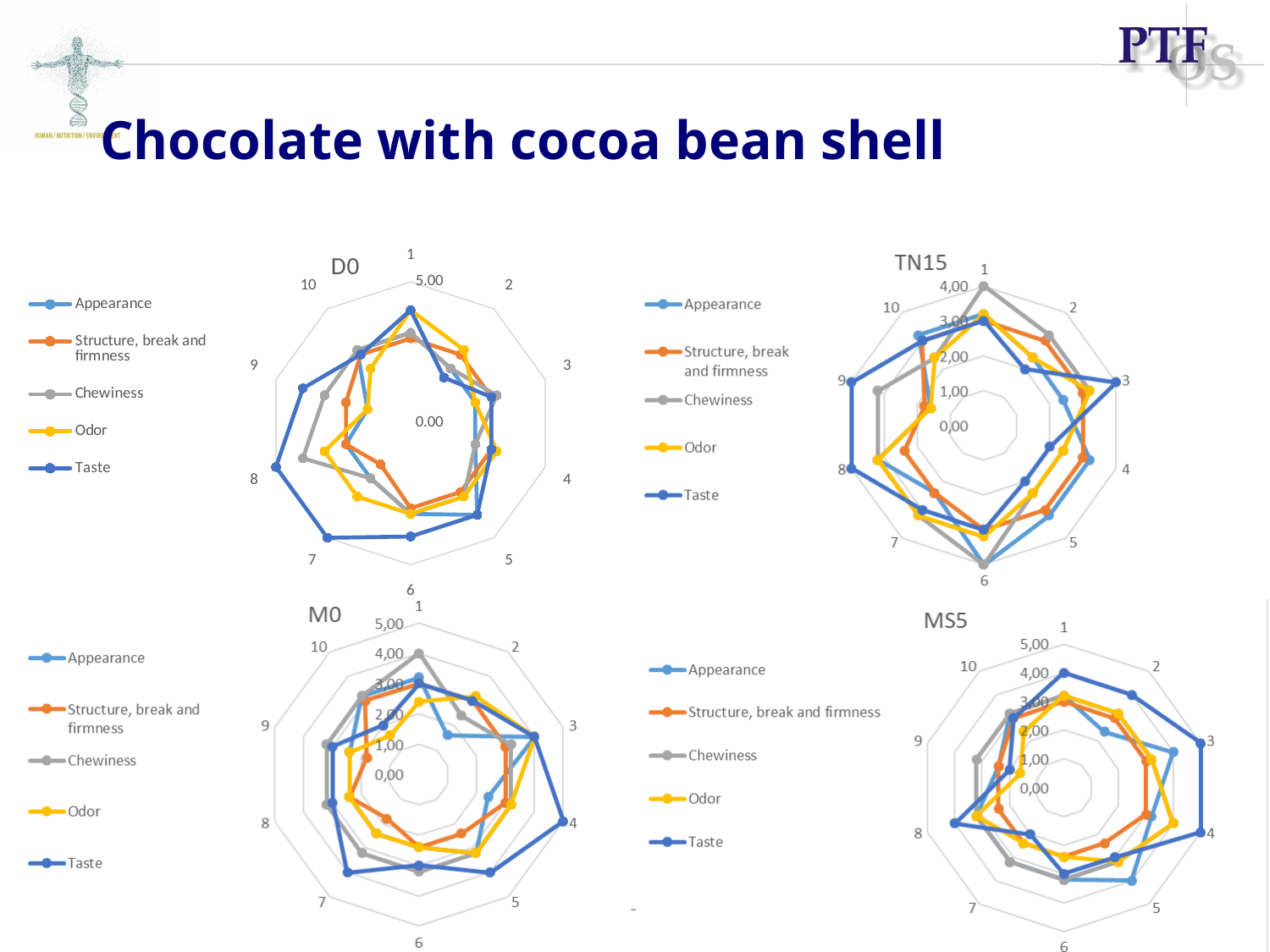
In the M0 chart, is the Taste value for category 4 greater or less than 4,00? greater How many categories (axes) does the MS5 radar chart have? 10 How many series does the legend of the TN15 chart list? 5 In the TN15 chart, is the Taste value for category 3 greater or less than 3,00? greater In the TN15 chart, is the Chewiness value for category 6 greater or less than 3,00? greater What kind of chart is the D0 chart? radar chart How many categories (axes) does the M0 radar chart have? 10 What are the titles of the four radar charts on the slide? D0, TN15, M0, MS5 Which series is drawn in dark blue in the MS5 chart legend? Taste